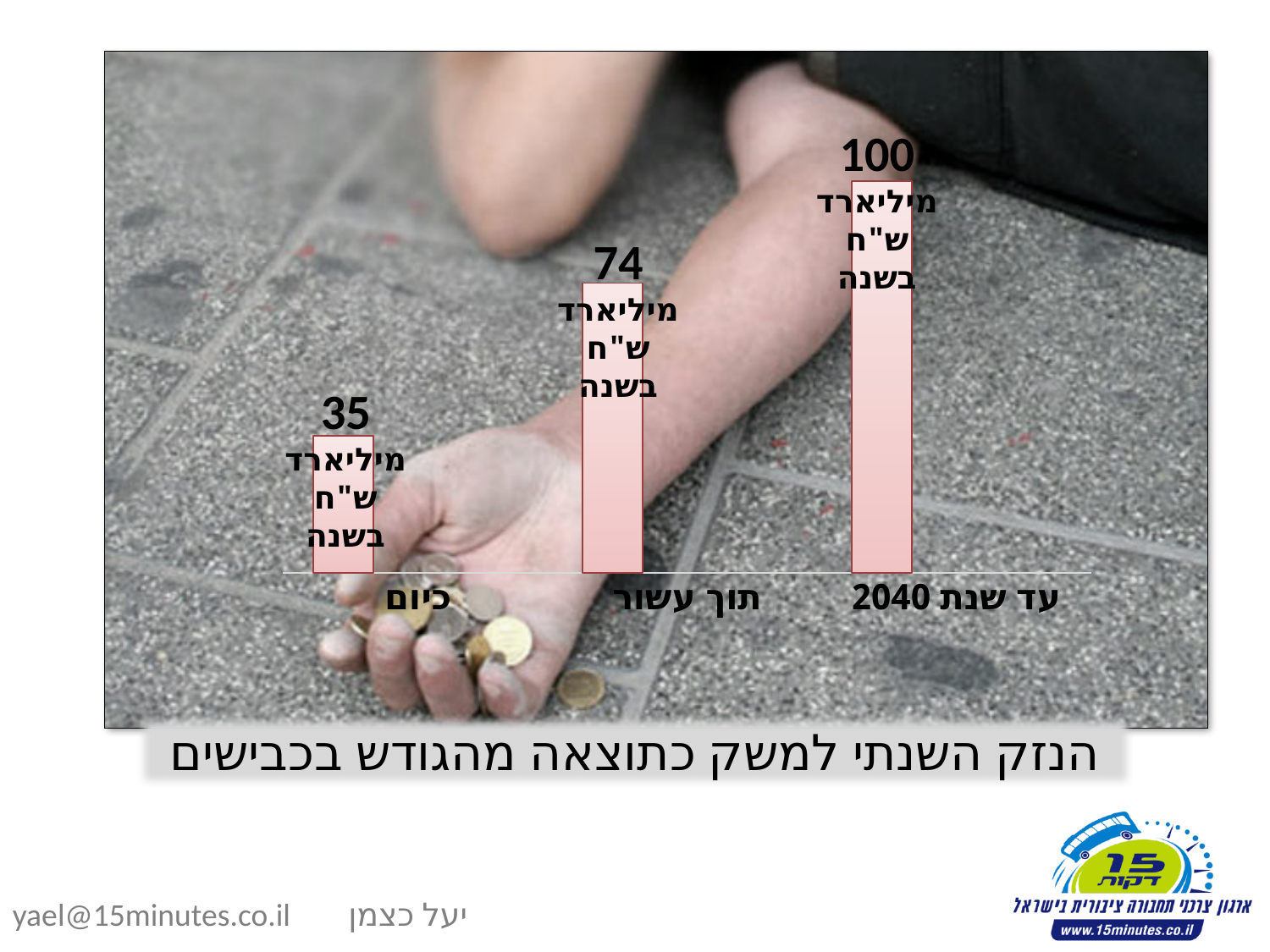
How many categories (bars) does the chart show? 3 What is the difference between the values for "עד שנת 2040" and "כיום"? 65 מיליארד ש"ח בשנה Which category has the lowest value? כיום Do the values rise or fall from "כיום" to "עד שנת 2040"? Rise What is the difference between the values for "תוך עשור" and "כיום"? 39 מיליארד ש"ח בשנה What value is shown for the category "כיום"? 35 מיליארד ש"ח בשנה What value is shown for the category "עד שנת 2040"? 100 מיליארד ש"ח בשנה What value is shown for the category "תוך עשור"? 74 מיליארד ש"ח בשנה Which is larger, the value for "תוך עשור" or the value for "כיום"? תוך עשור What is the caption/title written below the chart? הנזק השנתי למשק כתוצאה מהגודש בכבישים What kind of chart is shown on the slide? Bar chart Which category has the highest value? עד שנת 2040